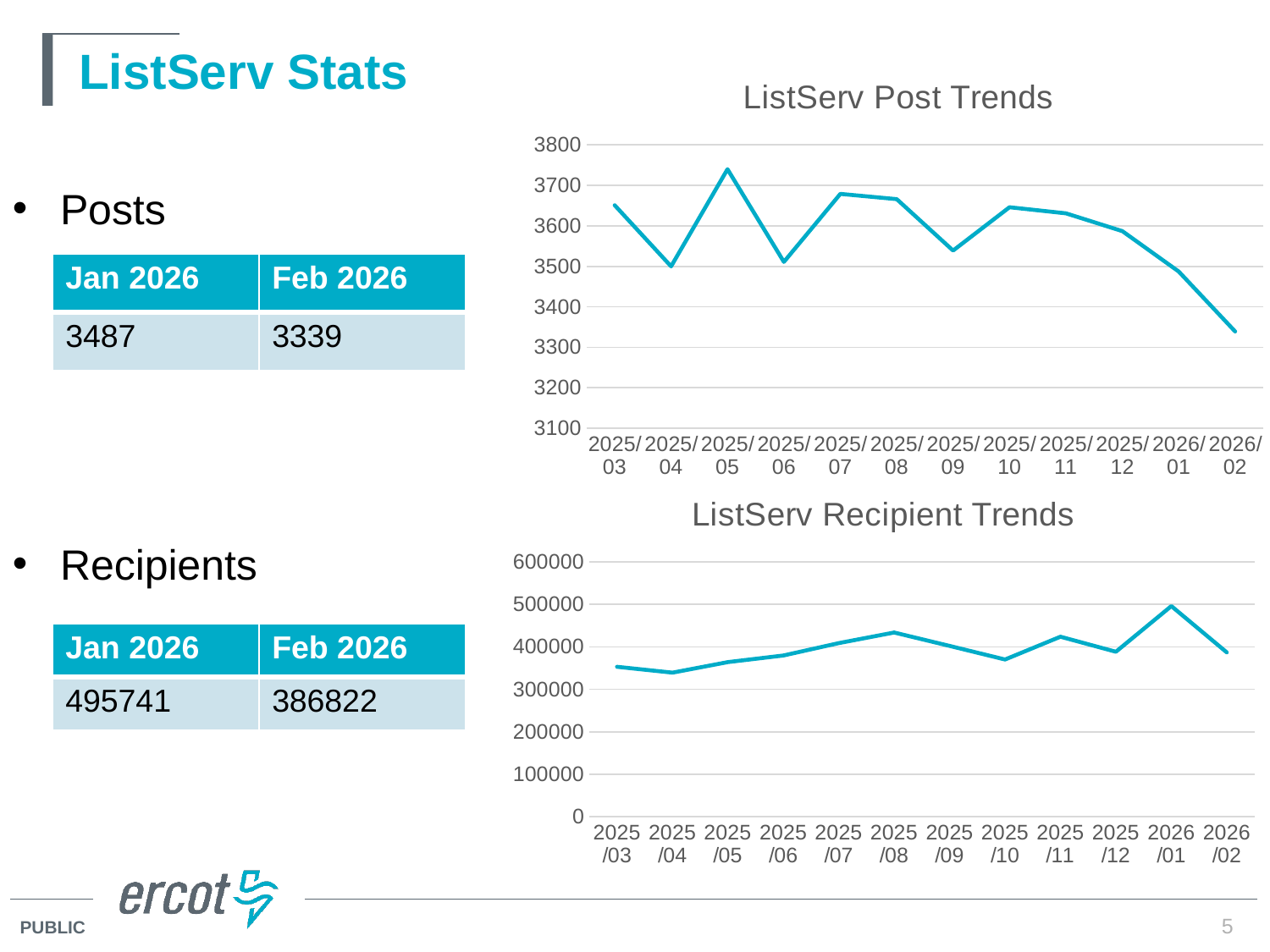
On the ListServ Recipient Trends chart, which is larger, the value for 2025/08 or the value for 2025/09? 2025/08 On the ListServ Post Trends chart, which month has the highest value? 2025/05 On the ListServ Recipient Trends chart, which month has the highest value? 2026/01 On the ListServ Post Trends chart, what is the value for 2026/02? 3339 How many data points are plotted on the ListServ Post Trends chart? 12 On the ListServ Post Trends chart, is the value for 2026/02 greater or less than 3400? less On the ListServ Recipient Trends chart, is the value for 2026/01 greater or less than 400000? greater What kind of chart is the ListServ Post Trends chart? line chart On the ListServ Post Trends chart, what is the difference between the values for 2026/01 and 2026/02? 148 On the ListServ Post Trends chart, is the value for 2025/05 greater or less than 3700? greater On the ListServ Post Trends chart, do the values rise or fall from 2025/10 to 2026/02? fall On the ListServ Post Trends chart, which month has the lowest value? 2026/02